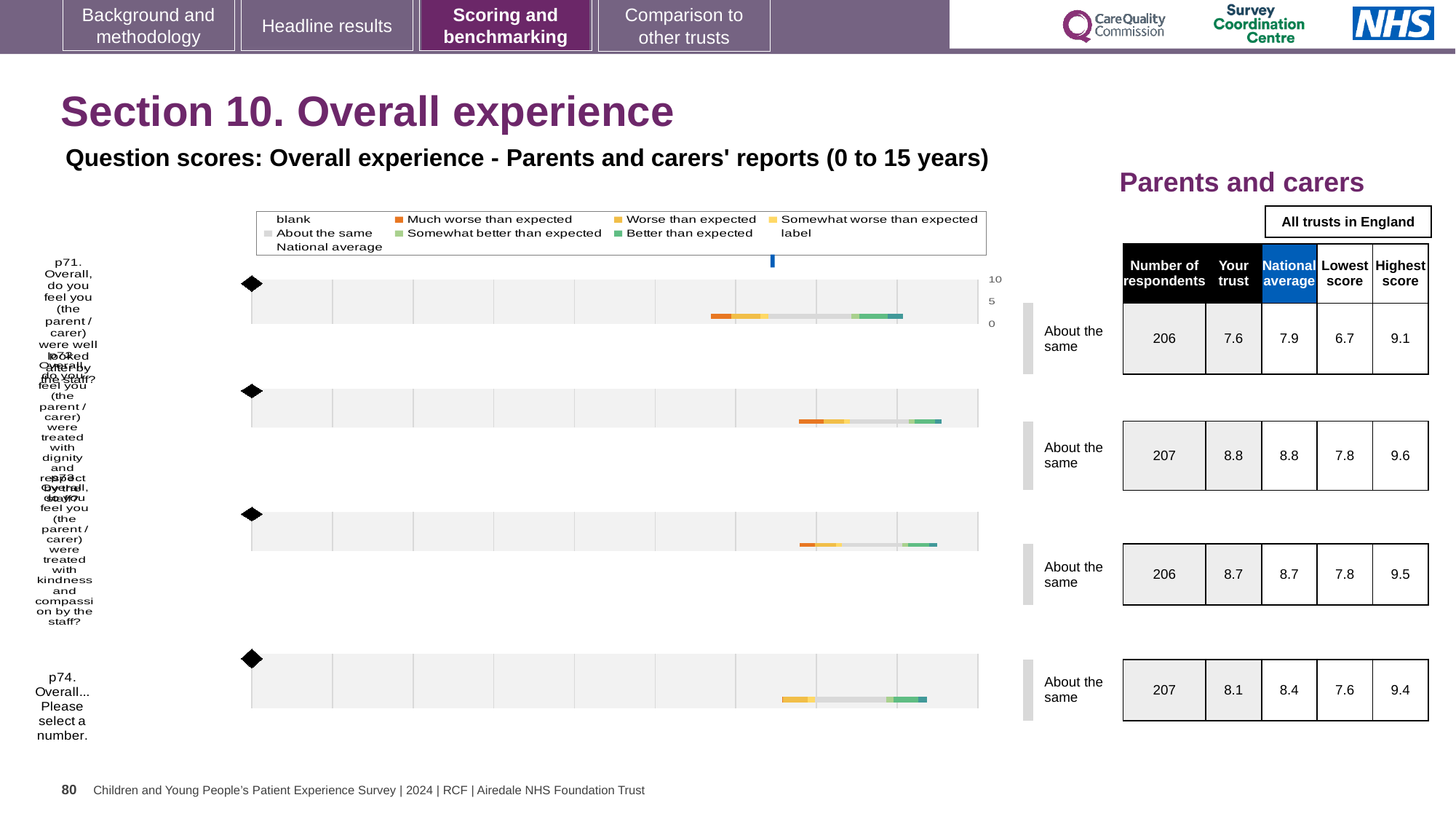
What is the difference between the Highest score and the Lowest score for p71? 2.4 What kind of chart is shown on the slide? bar chart What is the National average score for p74 (Overall... Please select a number)? 8.4 What is the 'Your trust' score for p71 (Overall, do you feel you were well looked after by the staff?)? 7.6 What is the number of respondents for p74? 207 What is the subtitle of the chart on the slide? Question scores: Overall experience - Parents and carers' reports (0 to 15 years) How many question rows (bars) are plotted in the chart? 4 For p74, which is larger: the 'Your trust' score or the National average? National average How many entries does the chart legend list? 9 Which row has the highest 'Highest score' value in the table? the second row (9.6) What benchmark label is shown next to the p71 bar? About the same By how much does the National average exceed the 'Your trust' score for p74? 0.3